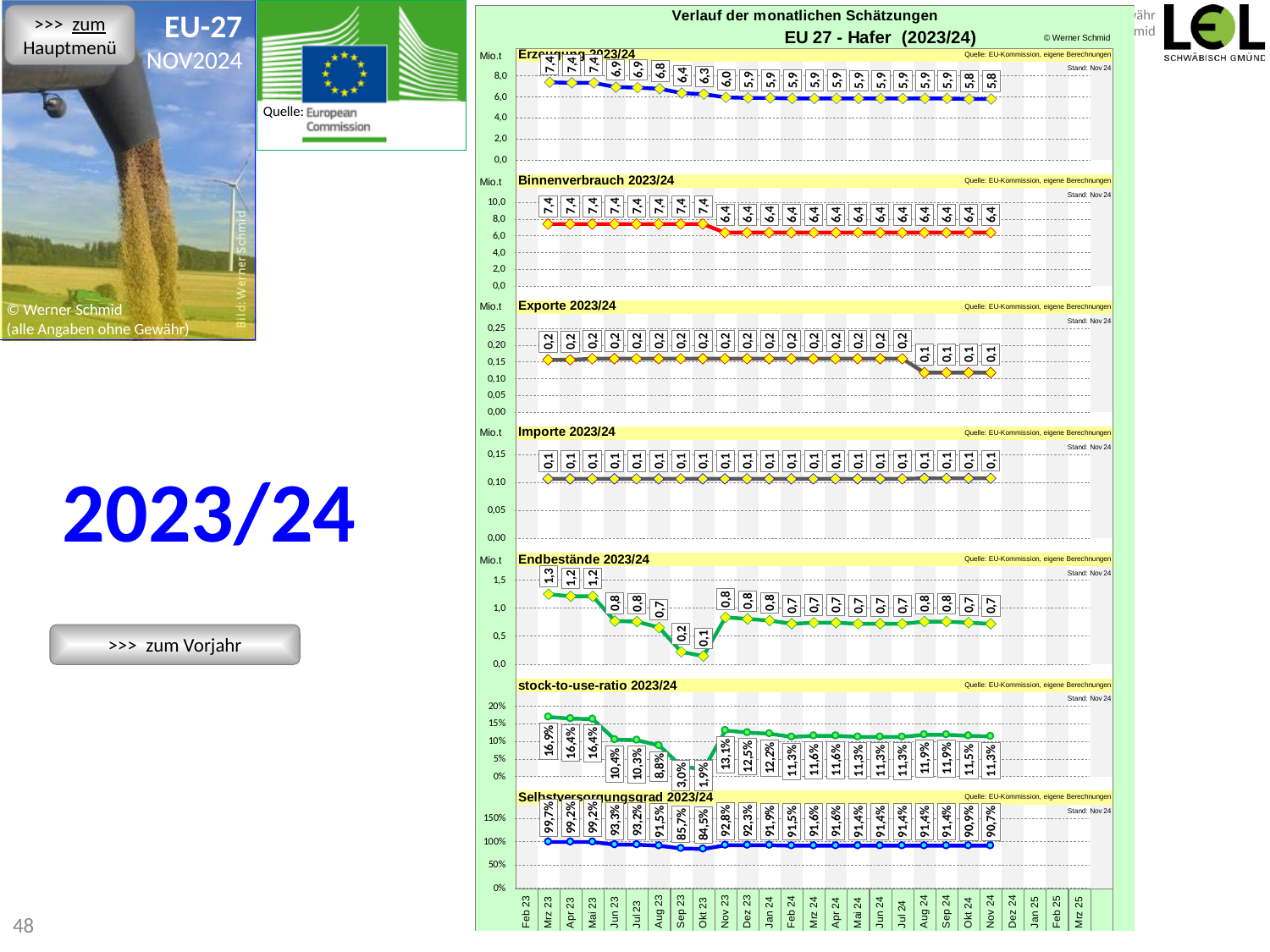
In the Binnenverbrauch 2023/24 chart, what is the value for Nov 24? 6,4 In the Erzeugung 2023/24 chart, do the values generally rise or fall from Mrz 23 to Nov 24? fall In the Erzeugung 2023/24 chart, what is the value for Mrz 23? 7,4 In the Selbstversorgungsgrad 2023/24 chart, what is the value for Nov 24? 90,7% In the stock-to-use-ratio 2023/24 chart, what is the value for Nov 24? 11,3% In the stock-to-use-ratio 2023/24 chart, what is the value for Okt 23? 1,9% In the Erzeugung 2023/24 chart, what is the value for Nov 24? 5,8 In the Endbestände 2023/24 chart, which month has the lowest value? Okt 23 What kind of chart is the Binnenverbrauch 2023/24 chart? line chart In the Endbestände 2023/24 chart, which month has the highest value? Mrz 23 In the Exporte 2023/24 chart, is the value for Nov 24 greater or less than 0,15? less In the Erzeugung 2023/24 chart, what is the difference between the Mrz 23 value and the Nov 24 value? 1,6